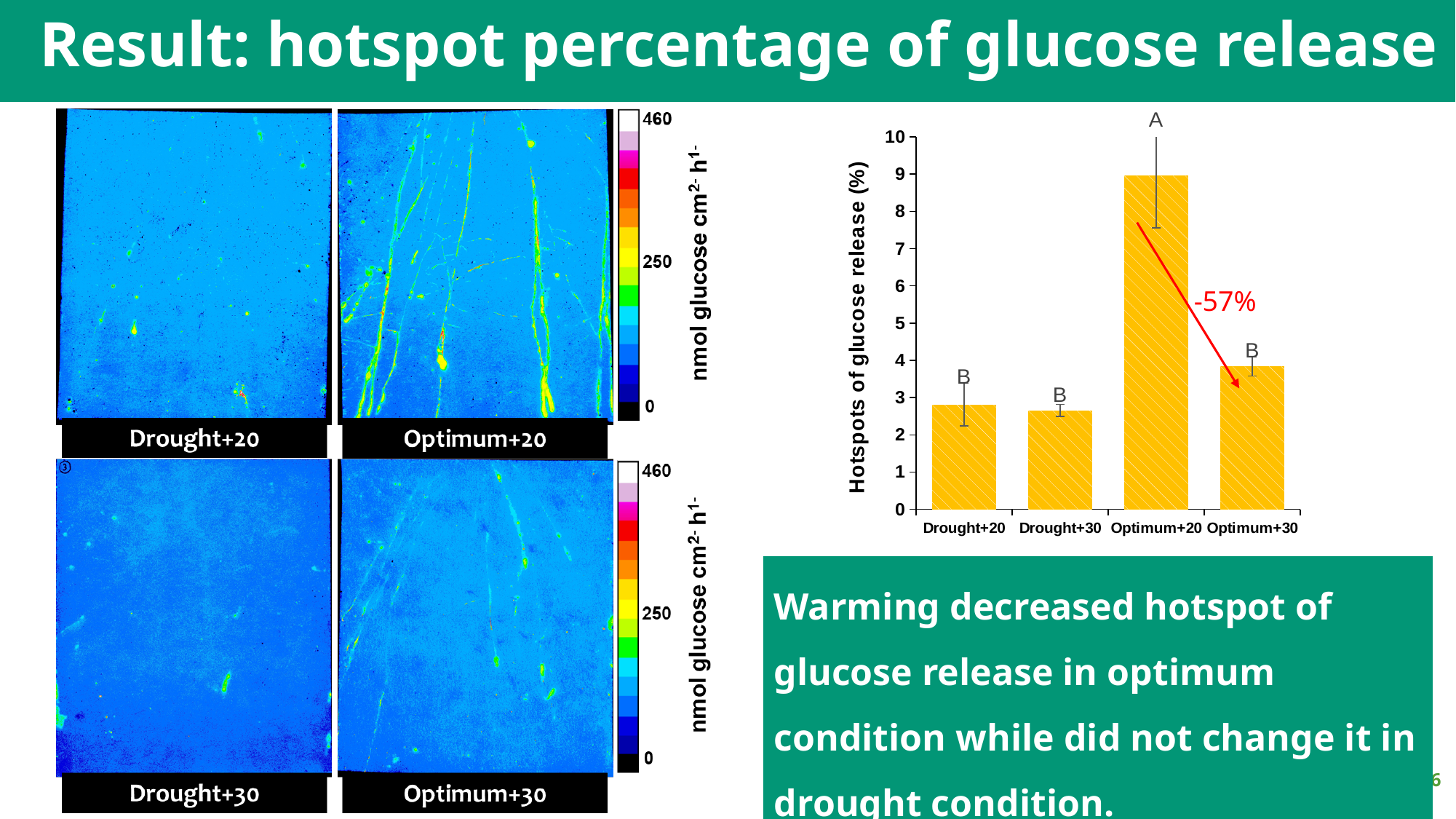
Is the value for Optimum+30 greater or less than 4? less Which is larger in the bar chart, the value for Drought+20 or the value for Optimum+20? Optimum+20 What kind of chart is shown on the right side of the slide? bar chart Is the value for Drought+20 greater or less than 3? less Is the value for Drought+30 greater or less than 2? greater What is the y-axis label of the bar chart? Hotspots of glucose release (%) Which category has the highest hotspot percentage of glucose release in the bar chart? Optimum+20 What percentage change is annotated by the red arrow between Optimum+20 and Optimum+30 in the bar chart? -57% How many categories are plotted on the bar chart? 4 What is the maximum value shown on the y-axis of the bar chart? 10 Which is larger in the bar chart, the value for Optimum+20 or the value for Optimum+30? Optimum+20